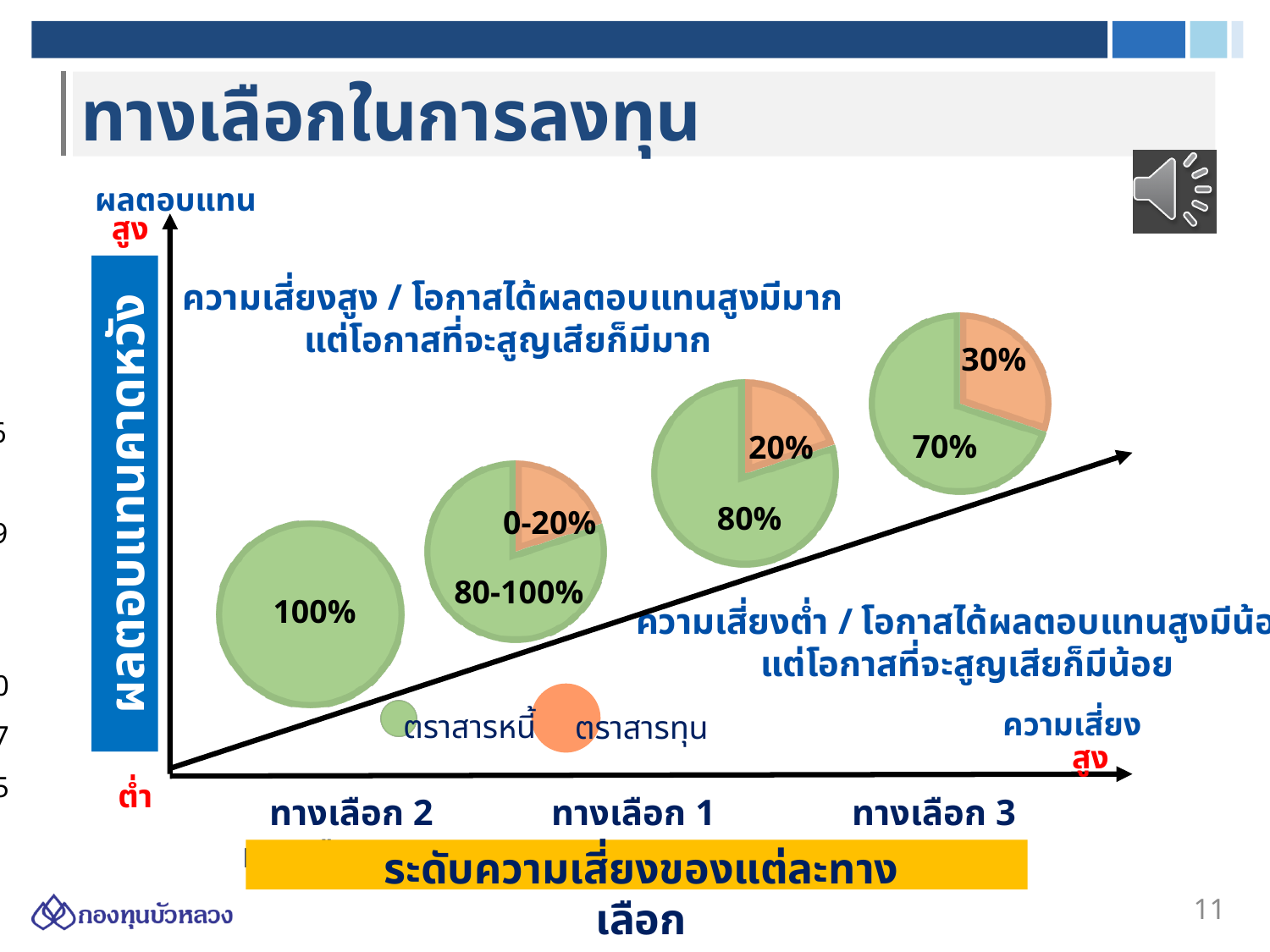
Which pie chart has the largest share of ตราสารทุน (orange): the third from the left or the rightmost? the rightmost In the rightmost pie chart, what share is shown for ตราสารหนี้ (green)? 70% Which colour represents ตราสารทุน in the pie charts? orange In the second pie chart from the left, what share is shown for ตราสารหนี้ (green)? 80-100% In the third pie chart from the left, what share is shown for ตราสารหนี้ (green)? 80% How many series does the legend list for the pie charts? 2 How many pie charts are shown on the slide? 4 What kind of charts are plotted on the slide? pie charts